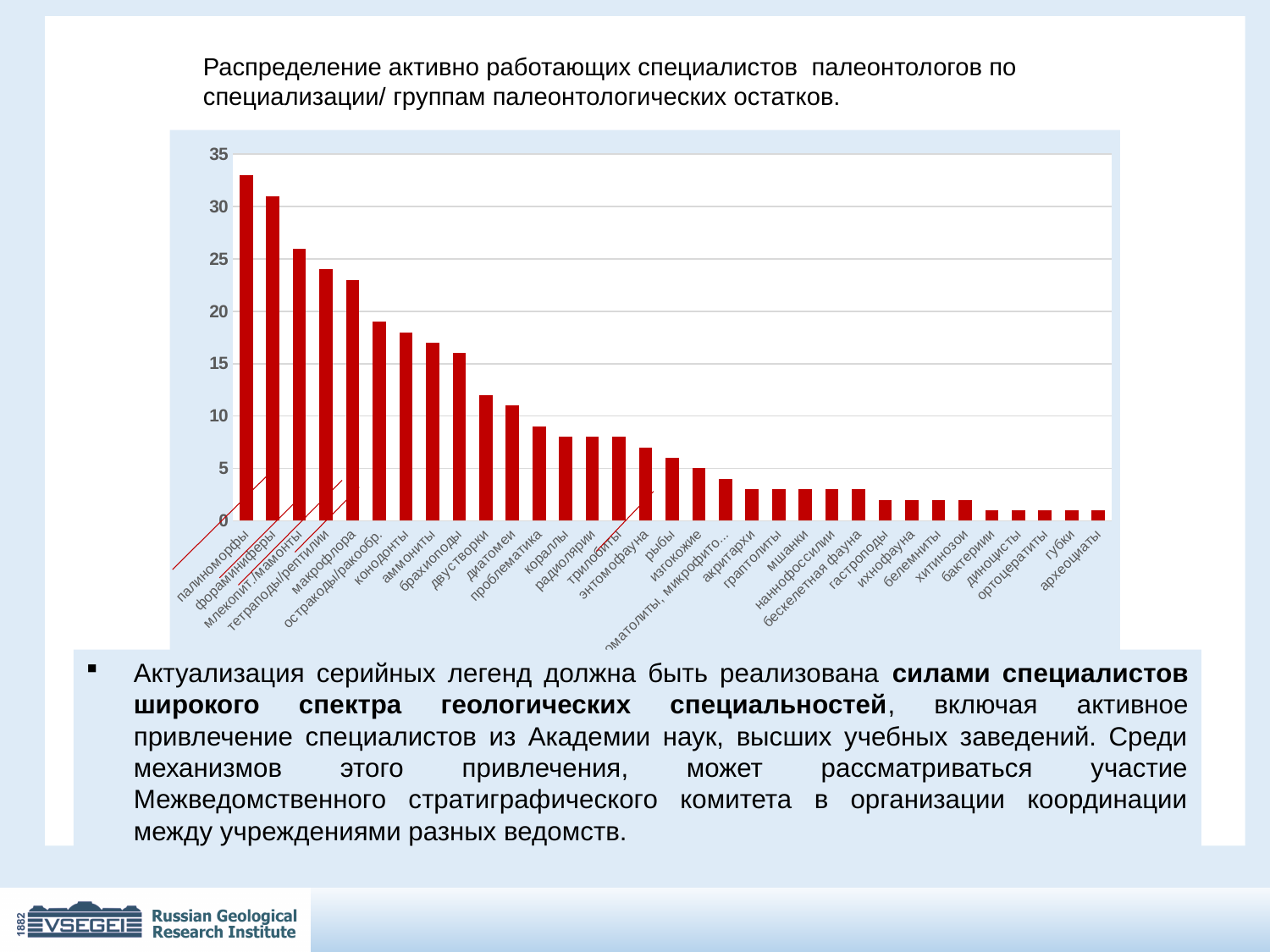
Which is larger, the value for конодонты or the value for двустворки? конодонты What kind of chart is shown on the slide? bar chart Which category has the highest value? палиноморфы Is the value for аммониты greater or less than 20? less Is the value for кораллы greater or less than 10? less What colour are the bars in the chart? red What is the highest value shown on the vertical axis? 35 Is the value for макрофлора greater or less than 25? less Do the values rise or fall from left to right along the x axis? fall Which is larger, the value for палиноморфы or the value for макрофлора? палиноморфы